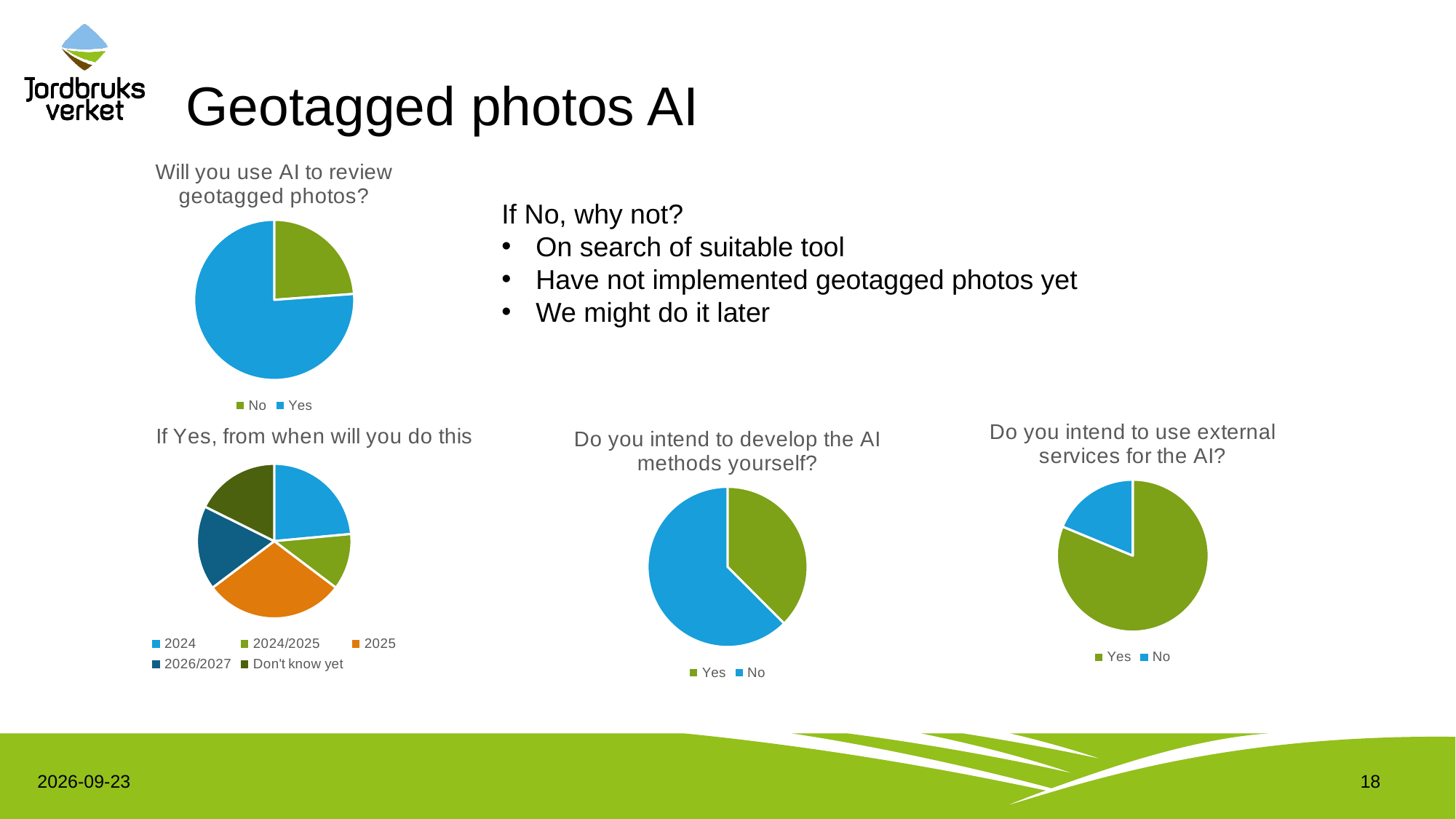
In the chart "If Yes, from when will you do this", which slice is larger: 2024 or 2024/2025? 2024 In the chart "Will you use AI to review geotagged photos?", which answer has the largest slice? Yes In the chart "If Yes, from when will you do this", which category has the smallest slice? 2024/2025 In the chart "If Yes, from when will you do this", which category has the largest slice? 2025 What kind of chart is "Will you use AI to review geotagged photos?"? Pie chart In the chart "Do you intend to use external services for the AI?", which answer has the larger slice? Yes In the chart "If Yes, from when will you do this", what colour is the 2025 slice? Orange In the chart "Will you use AI to review geotagged photos?", which answer has the smallest slice? No In the chart "Do you intend to use external services for the AI?", which slice is smaller: Yes or No? No How many pie charts are shown on the slide? 4 How many categories does the legend of the chart "If Yes, from when will you do this" list? 5